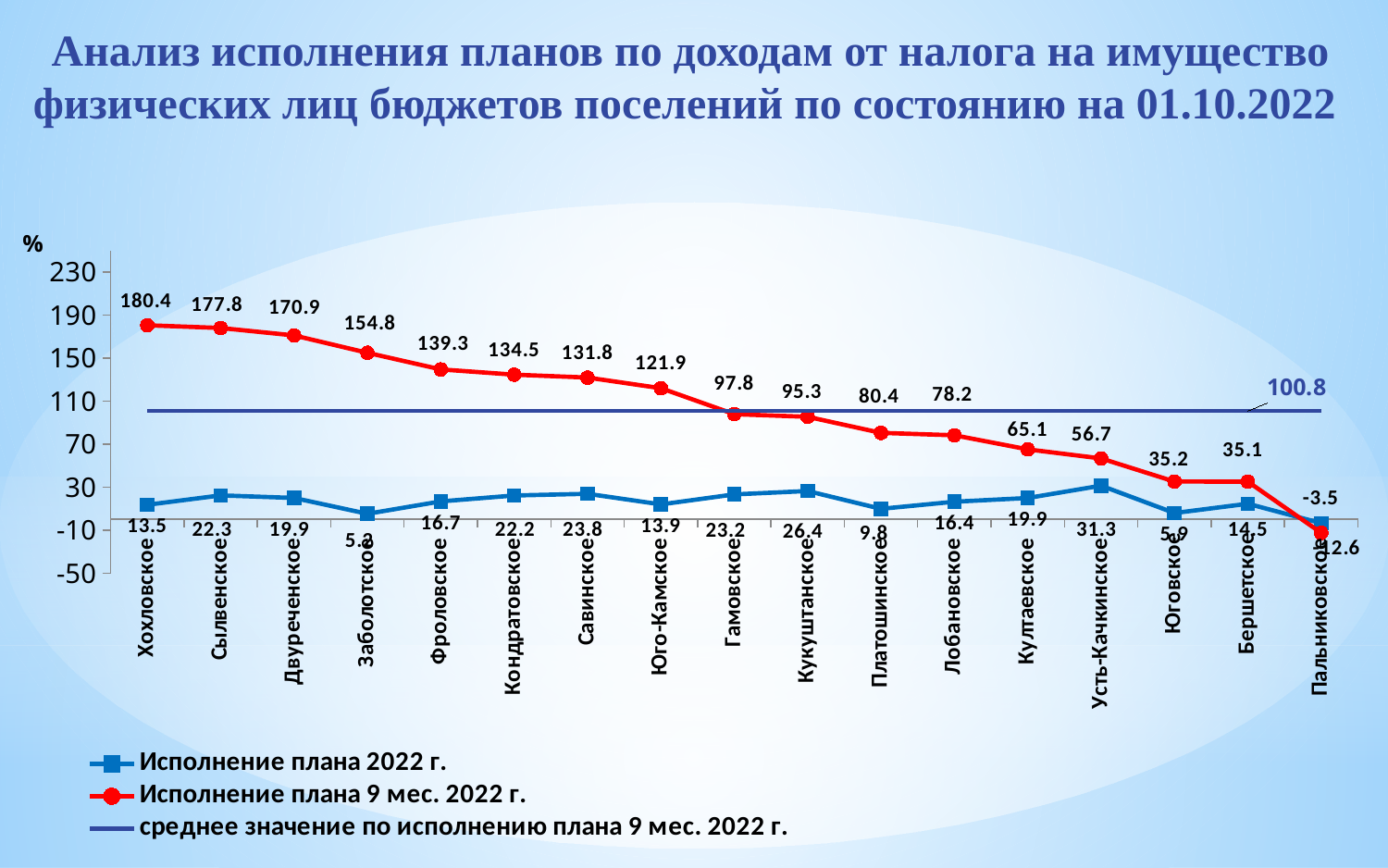
What is the value of the 'Исполнение плана 2022 г.' series for Усть-Качкинское? 31.3 How many settlements are shown on the x axis? 17 Which settlement has the highest value in the 'Исполнение плана 9 мес. 2022 г.' series? Хохловское What is the value of the 'Исполнение плана 2022 г.' series for Пальниковское? -3.5 What is the difference between the 'Исполнение плана 9 мес. 2022 г.' values for Хохловское and Сылвенское? 2.6 Which settlement has the highest value in the 'Исполнение плана 2022 г.' series? Усть-Качкинское What is the value of the 'Исполнение плана 9 мес. 2022 г.' series for Хохловское? 180.4 Which settlement has the lowest value in the 'Исполнение плана 9 мес. 2022 г.' series? Пальниковское What value is shown for the average line 'среднее значение по исполнению плана 9 мес. 2022 г.'? 100.8 How many entries does the legend list? 3 What kind of chart is shown on the slide? Line chart In the 'Исполнение плана 9 мес. 2022 г.' series, which is larger: Фроловское or Кондратовское? Фроловское